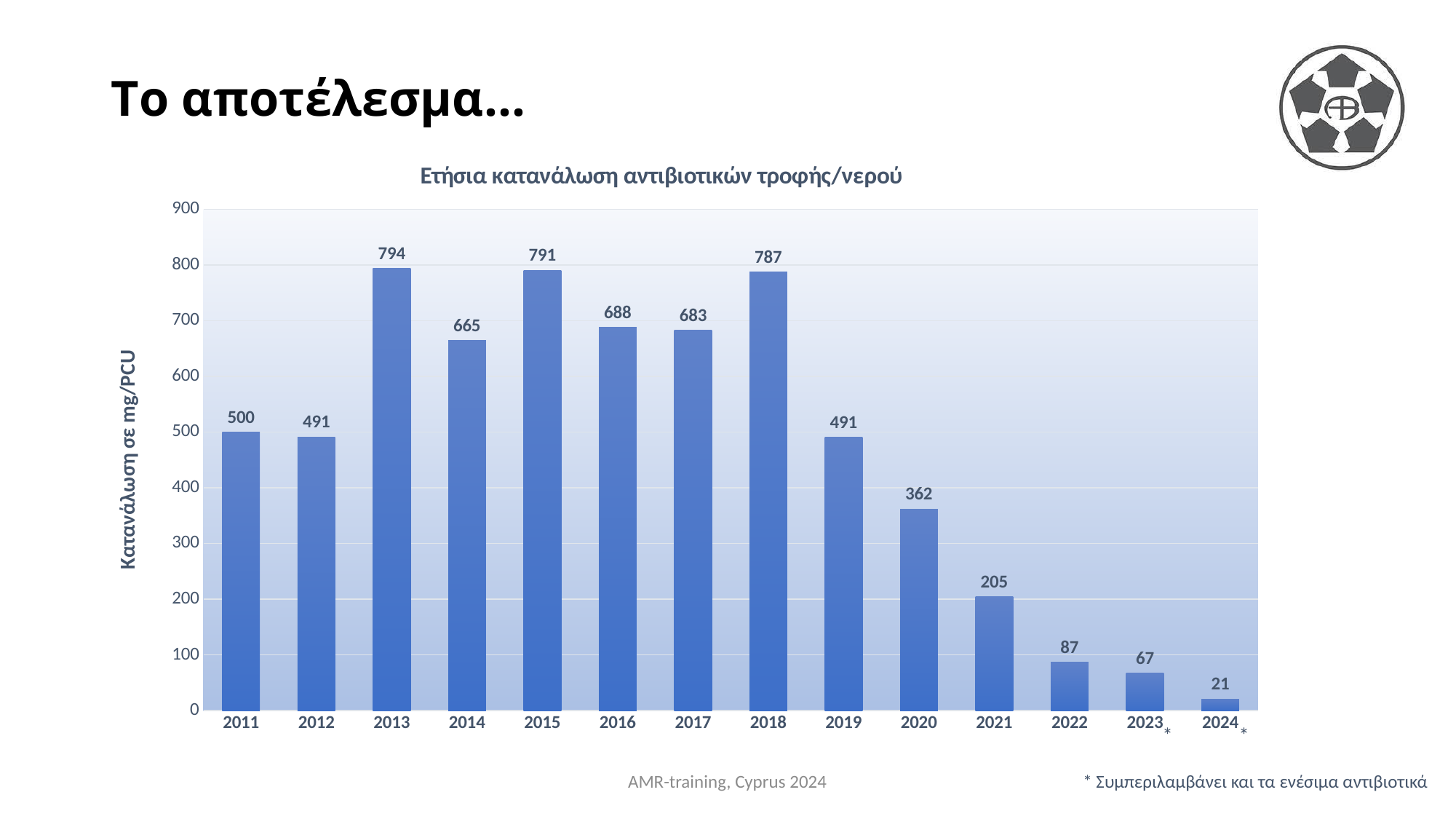
Is the value for 2021 greater or less than 300? less What is the value for 2024? 21 Which year has the highest value? 2013 How many years are shown on the x axis? 14 Which year has the lowest value? 2024 What is the value for 2013? 794 What kind of chart is shown? bar chart Which is larger, the value for 2014 or the value for 2016? 2016 What is the title of the chart? Ετήσια κατανάλωση αντιβιοτικών τροφής/νερού What is the value for 2020? 362 What is the difference between the values for 2018 and 2019? 296 Do the values rise or fall from 2018 to 2024? fall